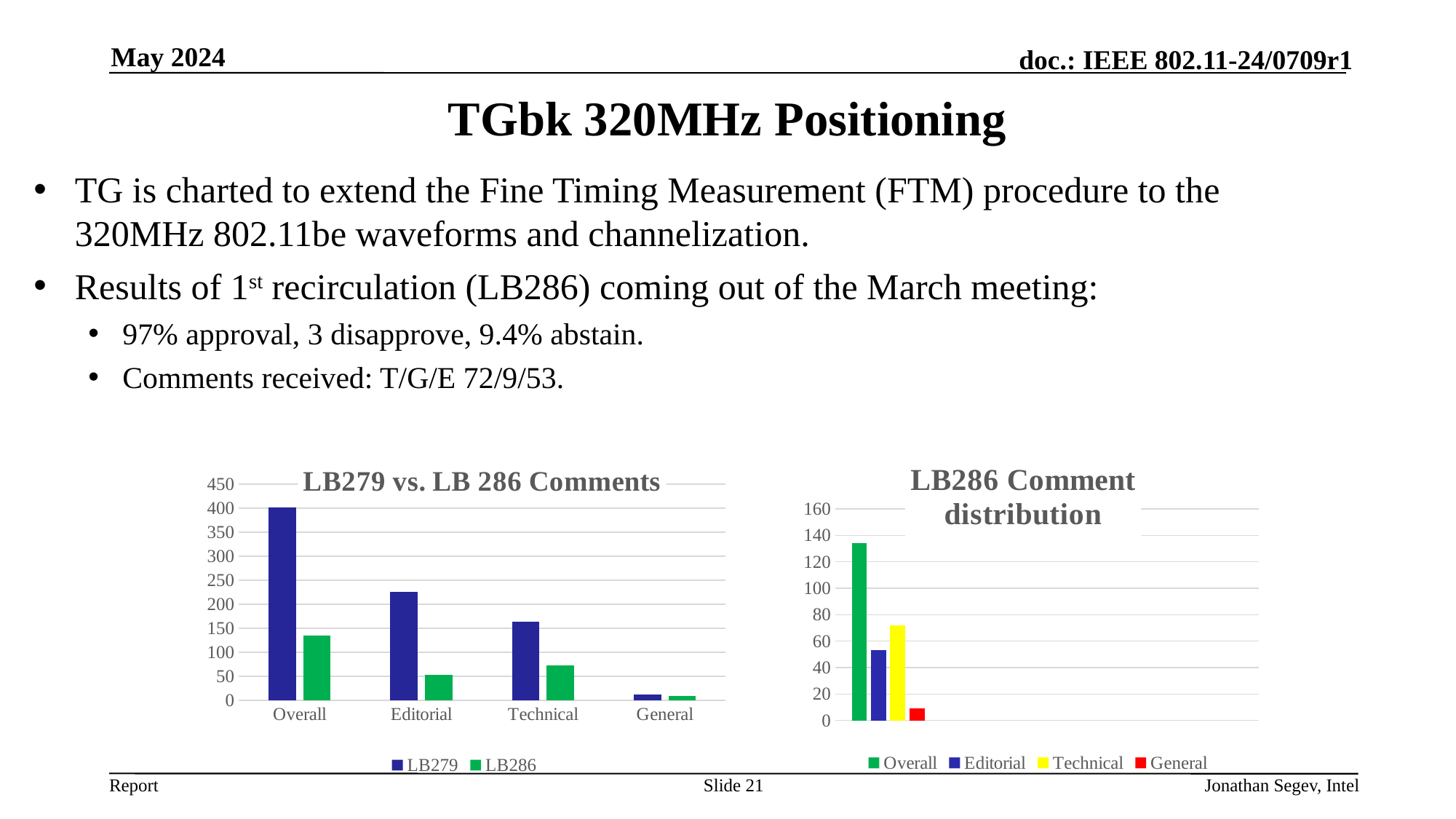
In the 'LB279 vs. LB 286 Comments' chart, is the LB279 value for Overall greater or less than 350? greater In the 'LB279 vs. LB 286 Comments' chart, is the LB286 value for Editorial greater or less than 100? less In the 'LB286 Comment distribution' chart, is the value for General greater or less than 20? less In the 'LB279 vs. LB 286 Comments' chart, which category has the lowest LB286 value? General In the 'LB279 vs. LB 286 Comments' chart, which is larger for LB286: Editorial or Technical? Technical How many series does the legend of the 'LB286 Comment distribution' chart list? 4 In the 'LB279 vs. LB 286 Comments' chart, which is larger for LB279: Editorial or Technical? Editorial In the 'LB286 Comment distribution' chart, which series has the highest value? Overall How many categories are shown on the x axis of the 'LB279 vs. LB 286 Comments' chart? 4 In the 'LB279 vs. LB 286 Comments' chart, which category has the highest LB279 value? Overall What kind of chart is the 'LB279 vs. LB 286 Comments' chart on the left? bar chart How many series does the legend of the 'LB279 vs. LB 286 Comments' chart list? 2